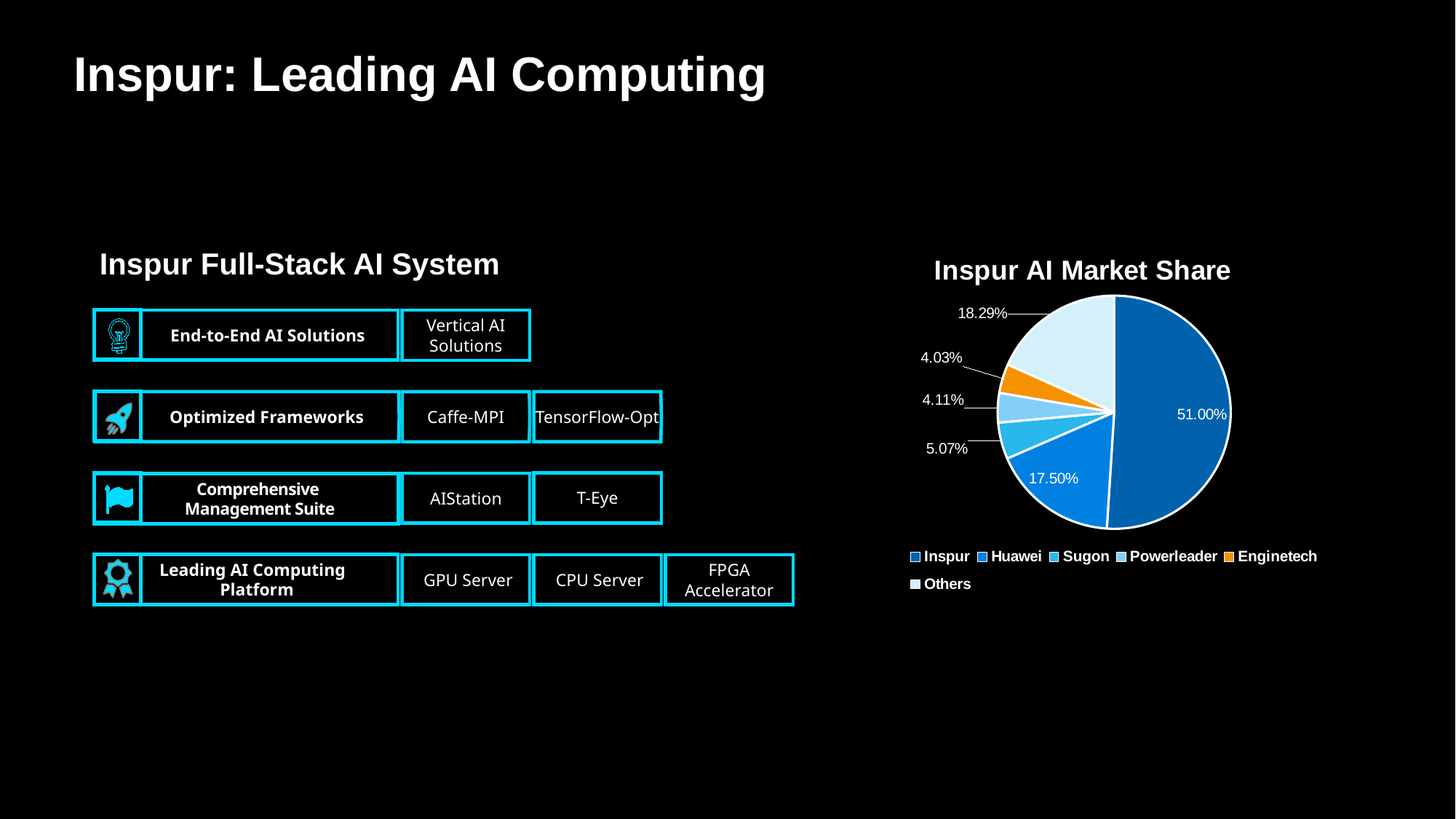
What type of chart is shown under the title "Inspur AI Market Share"? pie chart Which legend entry in the pie chart is shown in orange? Enginetech Which company has the largest slice in the Inspur AI Market Share pie chart? Inspur How many slices does the Inspur AI Market Share pie chart have? 6 What is the difference between Inspur's share and Huawei's share in the pie chart? 33.50% What is the share labelled for Sugon in the pie chart? 5.07% Which legend entry has the smallest slice in the pie chart? Enginetech What is Huawei's share in the Inspur AI Market Share pie chart? 17.50% What is the share labelled for Others in the pie chart? 18.29% What is Inspur's share in the Inspur AI Market Share pie chart? 51.00% What is the share labelled for Enginetech in the pie chart? 4.03% Which is larger in the pie chart, the Others slice or the Huawei slice? Others